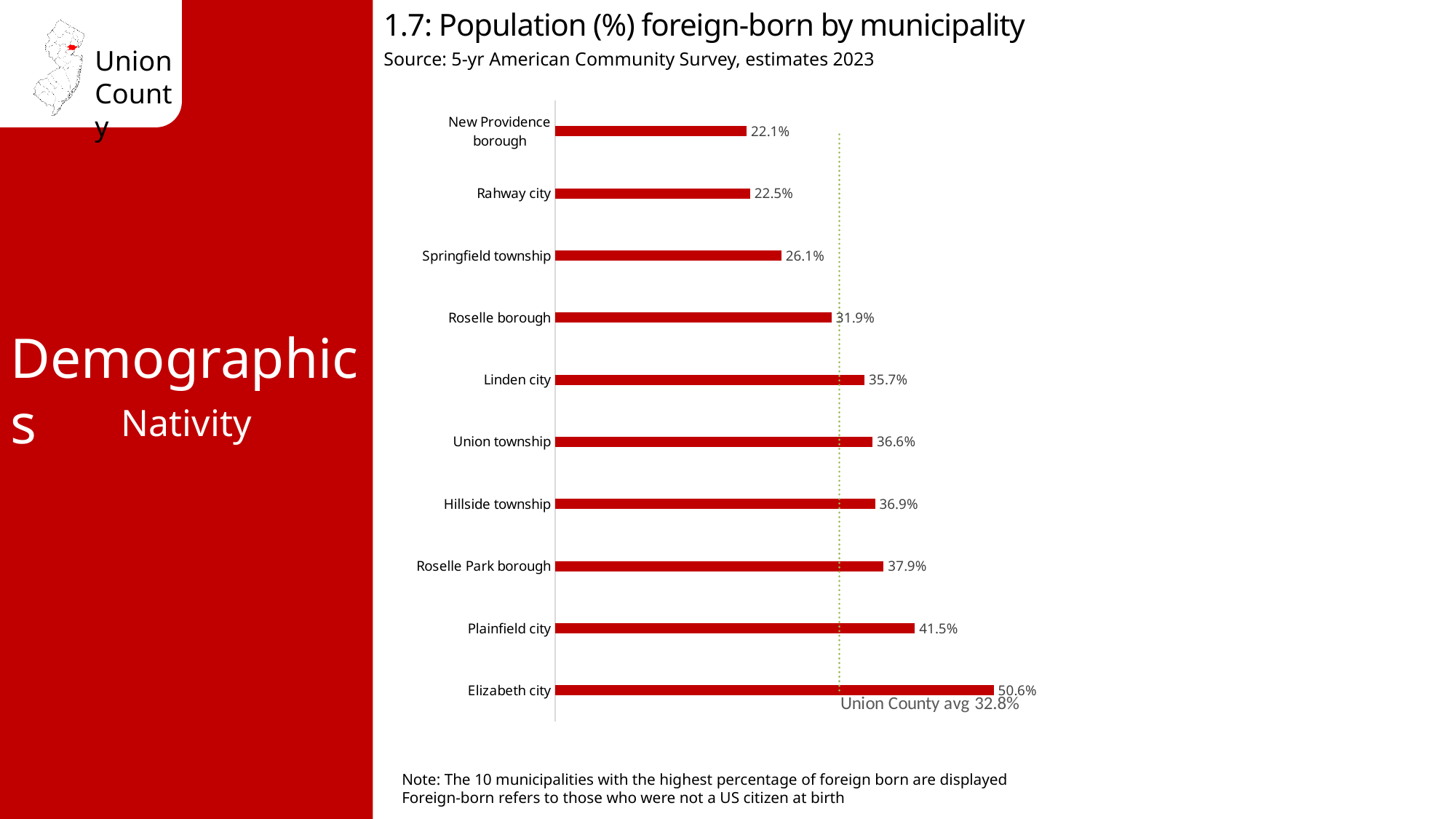
What is the source of the data shown in the chart? 5-yr American Community Survey, estimates 2023 What kind of chart is used on this slide? Bar chart Which has a higher foreign-born percentage, Roselle borough or Hillside township? Hillside township What is the Union County average foreign-born percentage marked by the dotted line? 32.8% Which municipality has the lowest percentage of foreign-born population on the chart? New Providence borough What is the difference in foreign-born percentage between Elizabeth city and Plainfield city? 9.1% How many municipalities are shown on the chart? 10 Which municipality has the highest percentage of foreign-born population? Elizabeth city What is the foreign-born population percentage for Roselle Park borough? 37.9% What is the difference in foreign-born percentage between Linden city and Rahway city? 13.2% What is the foreign-born population percentage for Springfield township? 26.1% What is the foreign-born population percentage for Elizabeth city? 50.6%